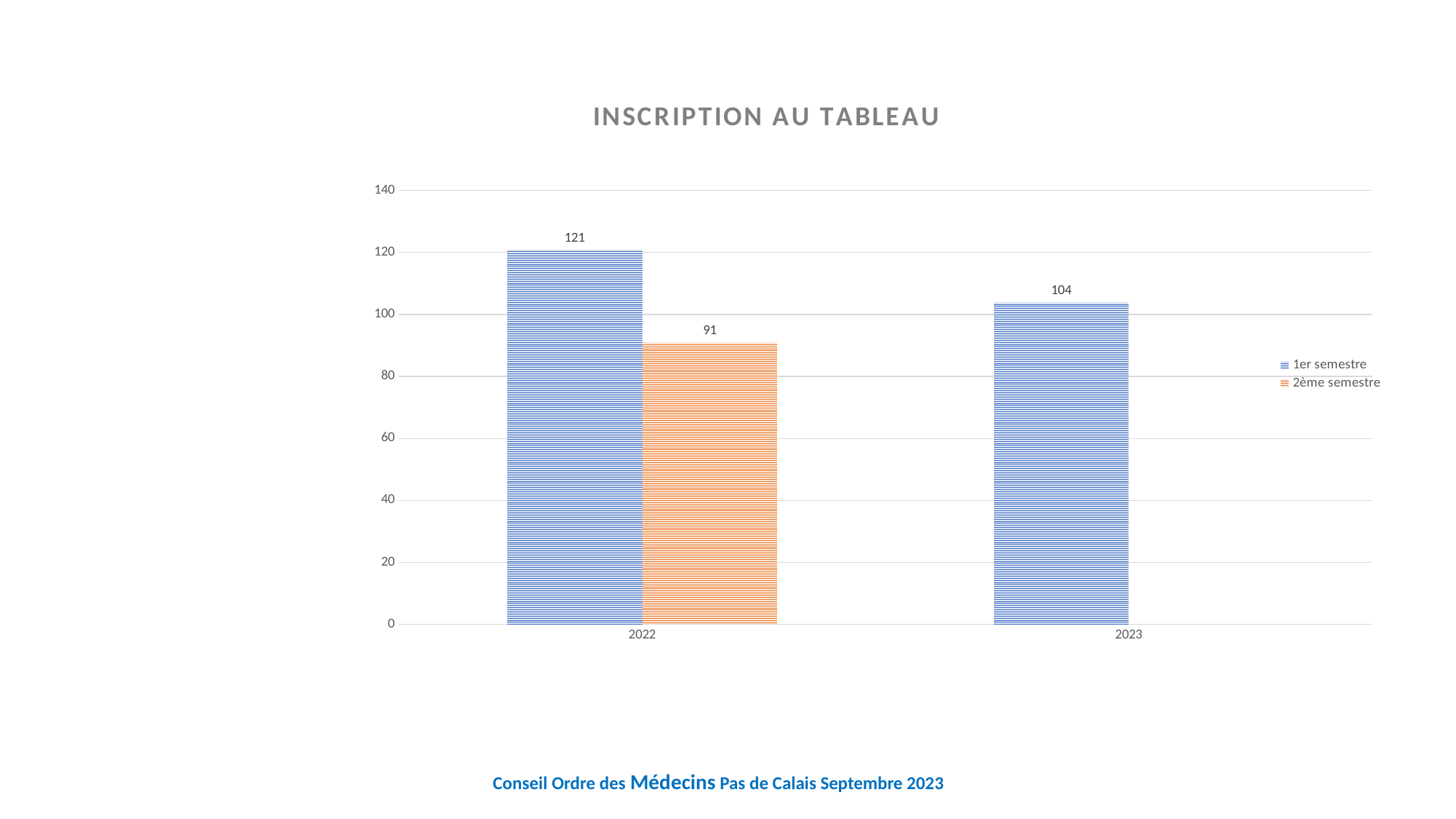
Which year has the highest 1er semestre value? 2022 What is the value for 1er semestre in 2023? 104 What is the difference between the 1er semestre values for 2022 and 2023? 17 Which is larger: the 1er semestre value in 2023 or the 2ème semestre value in 2022? 1er semestre in 2023 What is the difference between the 1er semestre and 2ème semestre values in 2022? 30 What is the value for 1er semestre in 2022? 121 How many years are shown on the x axis? 2 Is the value for 1er semestre in 2023 greater or less than 100? greater What kind of chart is shown on the slide? bar chart How many series does the legend list? 2 What is the value for 2ème semestre in 2022? 91 What is the title of the chart? INSCRIPTION AU TABLEAU